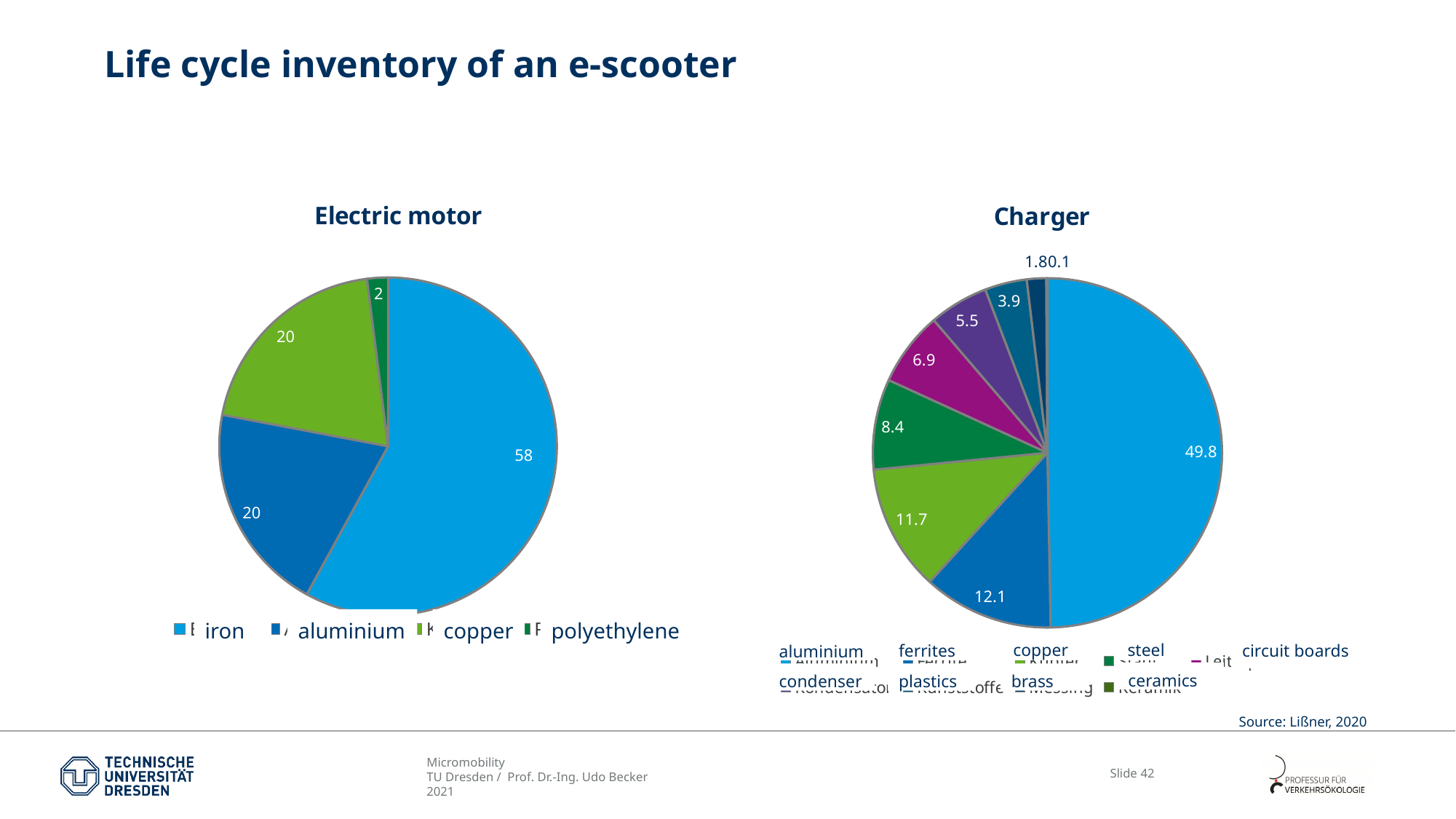
In the Electric motor pie chart, how many materials are shown? 4 In the Charger pie chart, which material has the largest slice? aluminium In the Charger pie chart, what is the value for aluminium? 49.8 In the Charger pie chart, which is larger, circuit boards or condenser? circuit boards In the Electric motor pie chart, which material has the smallest slice? polyethylene In the Charger pie chart, what is the value for steel? 8.4 What kind of chart is the Electric motor chart? pie chart In the Electric motor pie chart, what is the value for iron? 58 In the Electric motor pie chart, what is the value for polyethylene? 2 In the Electric motor pie chart, what is the difference between the values for iron and copper? 38 In the Electric motor pie chart, which material has the largest slice? iron In the Charger pie chart, what is the difference between the values for ferrites and copper? 0.4